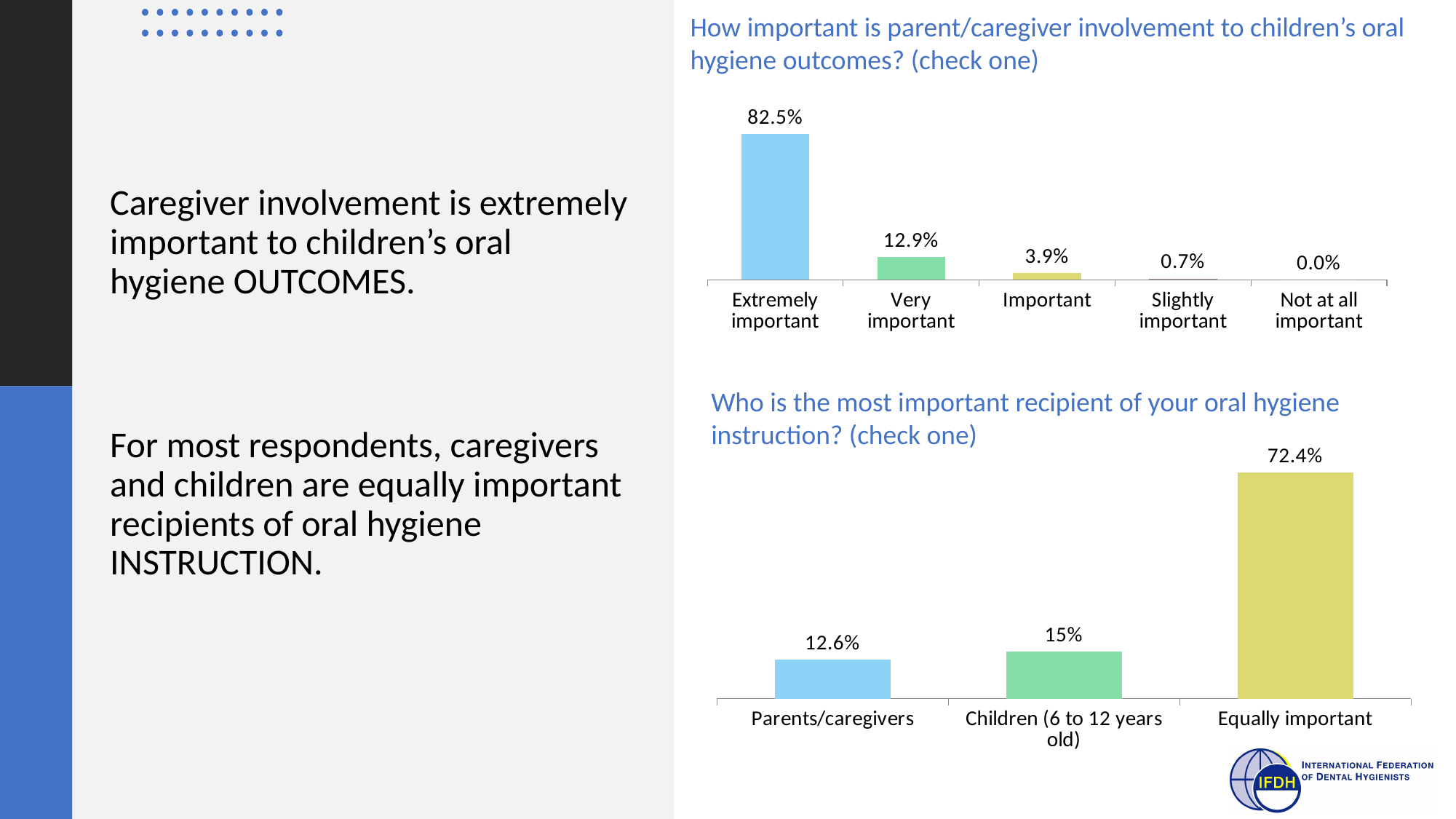
In the bottom chart (Who is the most important recipient of your oral hygiene instruction?), what is the value for 'Children (6 to 12 years old)'? 15% In the top chart (How important is parent/caregiver involvement to children's oral hygiene outcomes?), do the values rise or fall from left to right? fall In the bottom chart (Who is the most important recipient of your oral hygiene instruction?), which category has the highest value? Equally important In the top chart (How important is parent/caregiver involvement to children's oral hygiene outcomes?), what is the value for 'Slightly important'? 0.7% In the bottom chart (Who is the most important recipient of your oral hygiene instruction?), which is larger: 'Parents/caregivers' or 'Children (6 to 12 years old)'? Children (6 to 12 years old) In the top chart (How important is parent/caregiver involvement to children's oral hygiene outcomes?), which category has the lowest value? Not at all important What type of chart is the bottom chart (Who is the most important recipient of your oral hygiene instruction?)? bar chart In the top chart (How important is parent/caregiver involvement to children's oral hygiene outcomes?), what is the value for 'Very important'? 12.9% In the top chart (How important is parent/caregiver involvement to children's oral hygiene outcomes?), how many categories are shown? 5 In the top chart (How important is parent/caregiver involvement to children's oral hygiene outcomes?), what is the difference between 'Extremely important' and 'Very important'? 69.6% In the top chart (How important is parent/caregiver involvement to children's oral hygiene outcomes?), what percentage of respondents chose 'Extremely important'? 82.5% In the bottom chart (Who is the most important recipient of your oral hygiene instruction?), what is the value for 'Equally important'? 72.4%